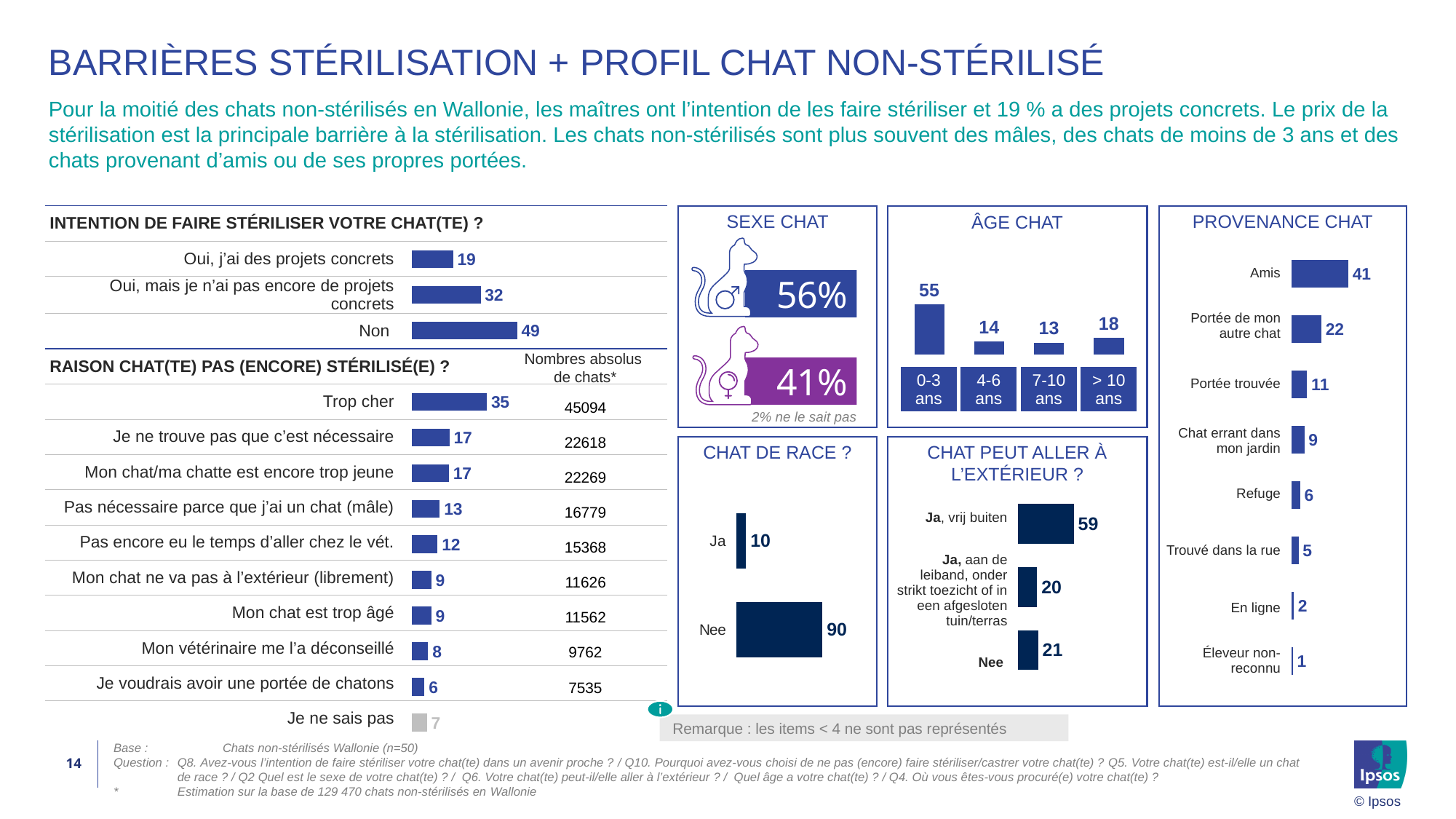
In the "CHAT DE RACE ?" chart, what is the value for "Nee"? 90 In the "ÂGE CHAT" chart, how many age categories are shown? 4 In the "CHAT PEUT ALLER À L'EXTÉRIEUR ?" chart, what is the value for "Ja, vrij buiten"? 59 In the "ÂGE CHAT" chart, which is larger: "4-6 ans" or "> 10 ans"? > 10 ans In the "RAISON CHAT(TE) PAS (ENCORE) STÉRILISÉ(E) ?" chart, which reason has the highest value? Trop cher In the "RAISON CHAT(TE) PAS (ENCORE) STÉRILISÉ(E) ?" chart, what is the absolute number of cats for "Trop cher"? 45094 In the "RAISON CHAT(TE) PAS (ENCORE) STÉRILISÉ(E) ?" chart, what is the value for "Mon vétérinaire me l'a déconseillé"? 8 In the "INTENTION DE FAIRE STÉRILISER VOTRE CHAT(TE) ?" chart, what is the value for "Non"? 49 In the "ÂGE CHAT" chart, which age group has the highest value? 0-3 ans In the "PROVENANCE CHAT" chart, which source has the lowest value? Éleveur non-reconnu In the "SEXE CHAT" chart, what percentage of cats are male? 56% In the "INTENTION DE FAIRE STÉRILISER VOTRE CHAT(TE) ?" chart, what is the difference between "Non" and "Oui, j'ai des projets concrets"? 30